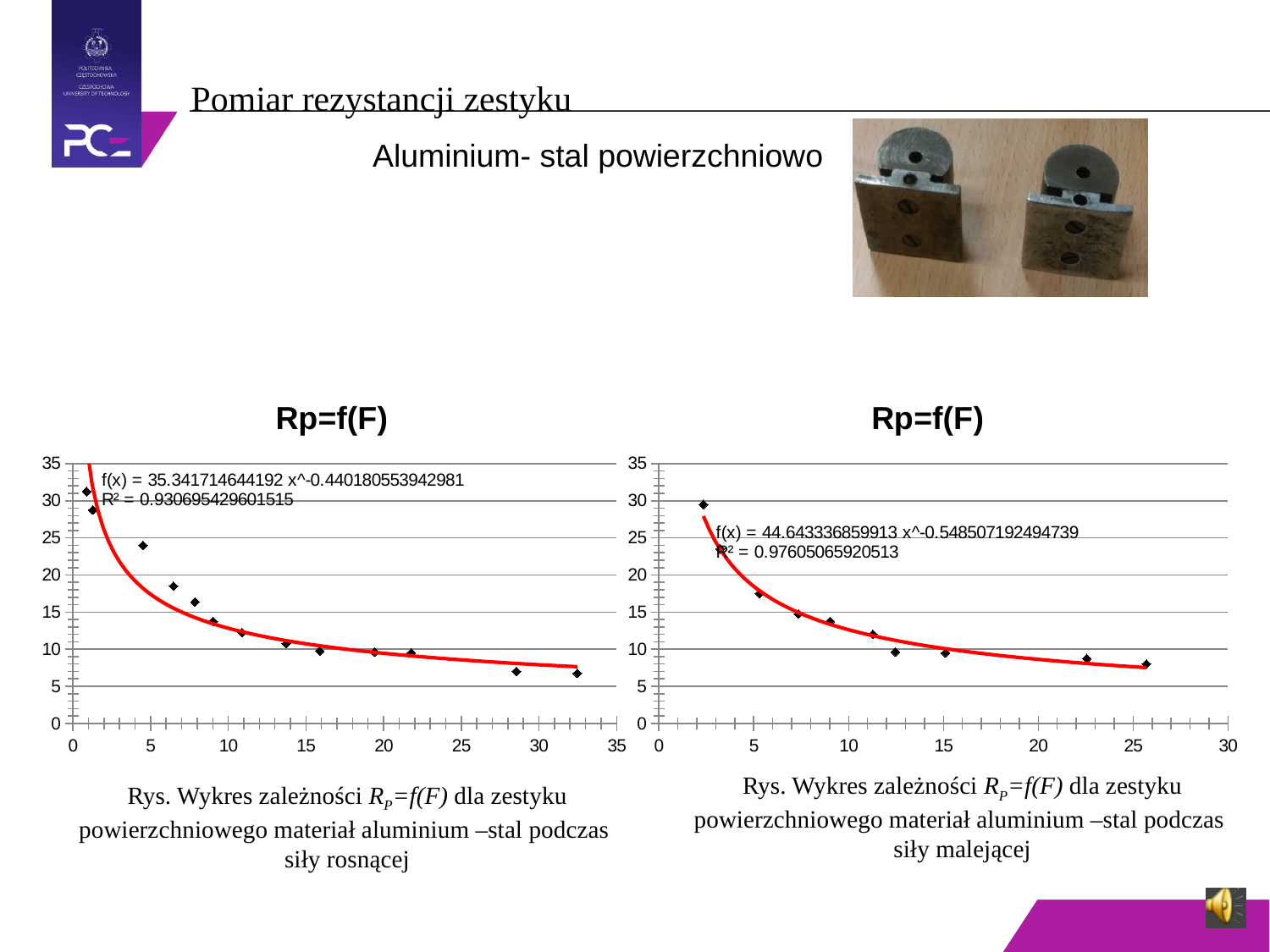
In the left chart (siły rosnącej), do the plotted values rise or fall as F increases along the x axis? fall What R² value is printed on the right chart? R² = 0.97605065920513 In the left chart, is the value of the rightmost point (near F = 32) greater or less than 10? less In the right chart (siły malejącej), do the plotted values rise or fall as F increases along the x axis? fall In the left chart, is the value of the point near F = 14 greater or less than 15? less In the left chart, which point has the larger value: the leftmost point (near F = 1) or the rightmost point (near F = 32)? the leftmost point (near F = 1) In the right chart, is the value of the rightmost point (near F = 26) greater or less than 10? less In the right chart, which point has the larger value: the point near F = 2 or the point near F = 15? the point near F = 2 What type of chart is the left chart titled Rp=f(F)? scatter chart What R² value is printed on the left chart? R² = 0.930695429601515 What is the maximum value shown on the x axis of the right chart? 30